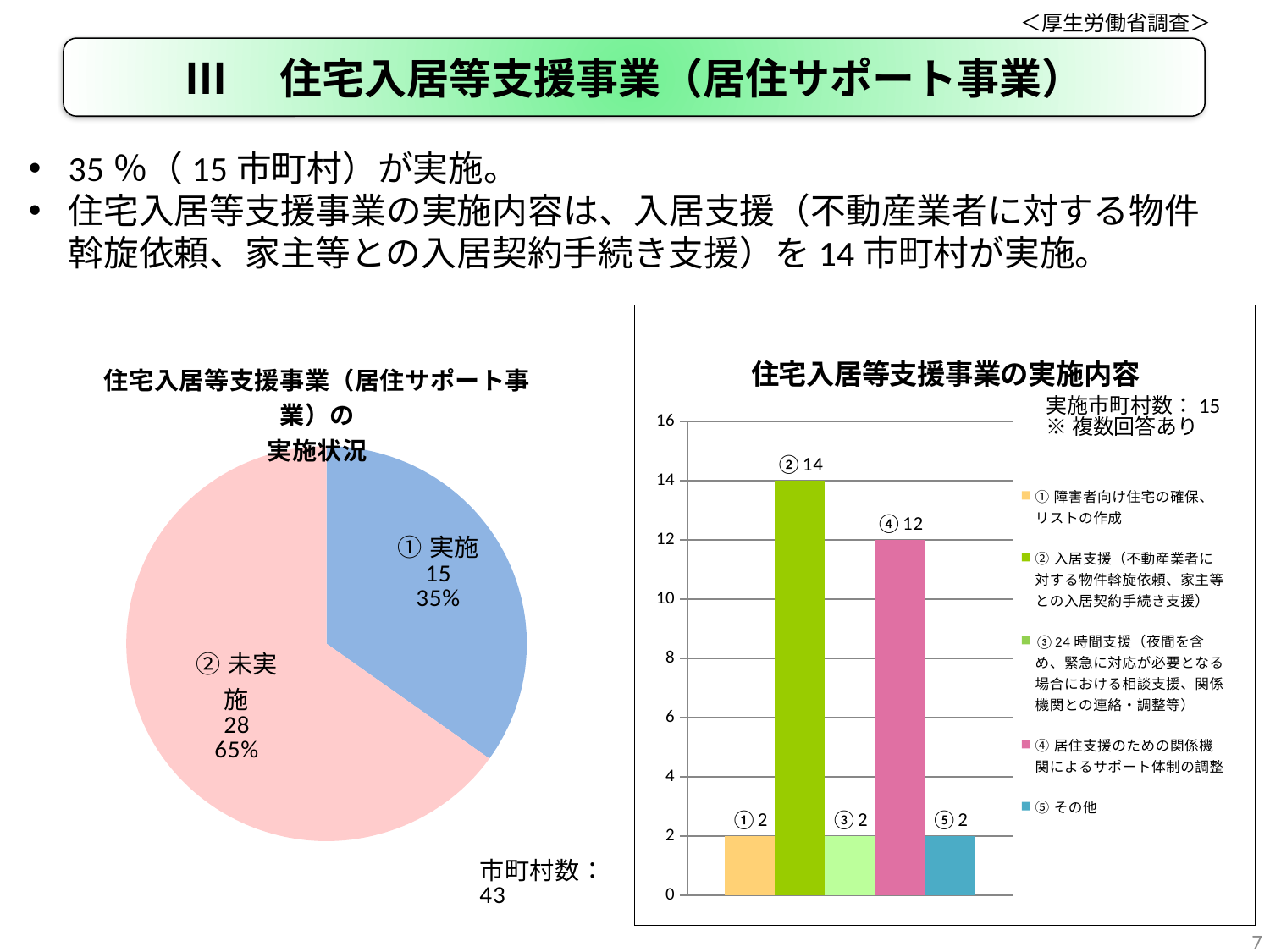
In the bar chart titled 住宅入居等支援事業の実施内容, how many entries does the legend list? 5 In the bar chart titled 住宅入居等支援事業の実施内容, what is the value for ② 入居支援? 14 In the pie chart on the left, what percentage is shown for ① 実施? 35% In the bar chart titled 住宅入居等支援事業の実施内容, how many bars are plotted? 5 In the pie chart on the left, how many municipalities are in the ② 未実施 slice? 28 In the bar chart titled 住宅入居等支援事業の実施内容, what is the value for ④ 居住支援のための関係機関によるサポート体制の調整? 12 In the pie chart on the left, what is the difference in municipality count between ② 未実施 and ① 実施? 13 In the bar chart titled 住宅入居等支援事業の実施内容, what is the difference between the values for ② and ④? 2 In the pie chart on the left, which slice is larger, ① 実施 or ② 未実施? ② 未実施 In the bar chart titled 住宅入居等支援事業の実施内容, is the value for ④ greater or less than 10? greater What kind of chart is the chart on the left? Pie chart In the bar chart titled 住宅入居等支援事業の実施内容, which category has the highest value? ② 入居支援